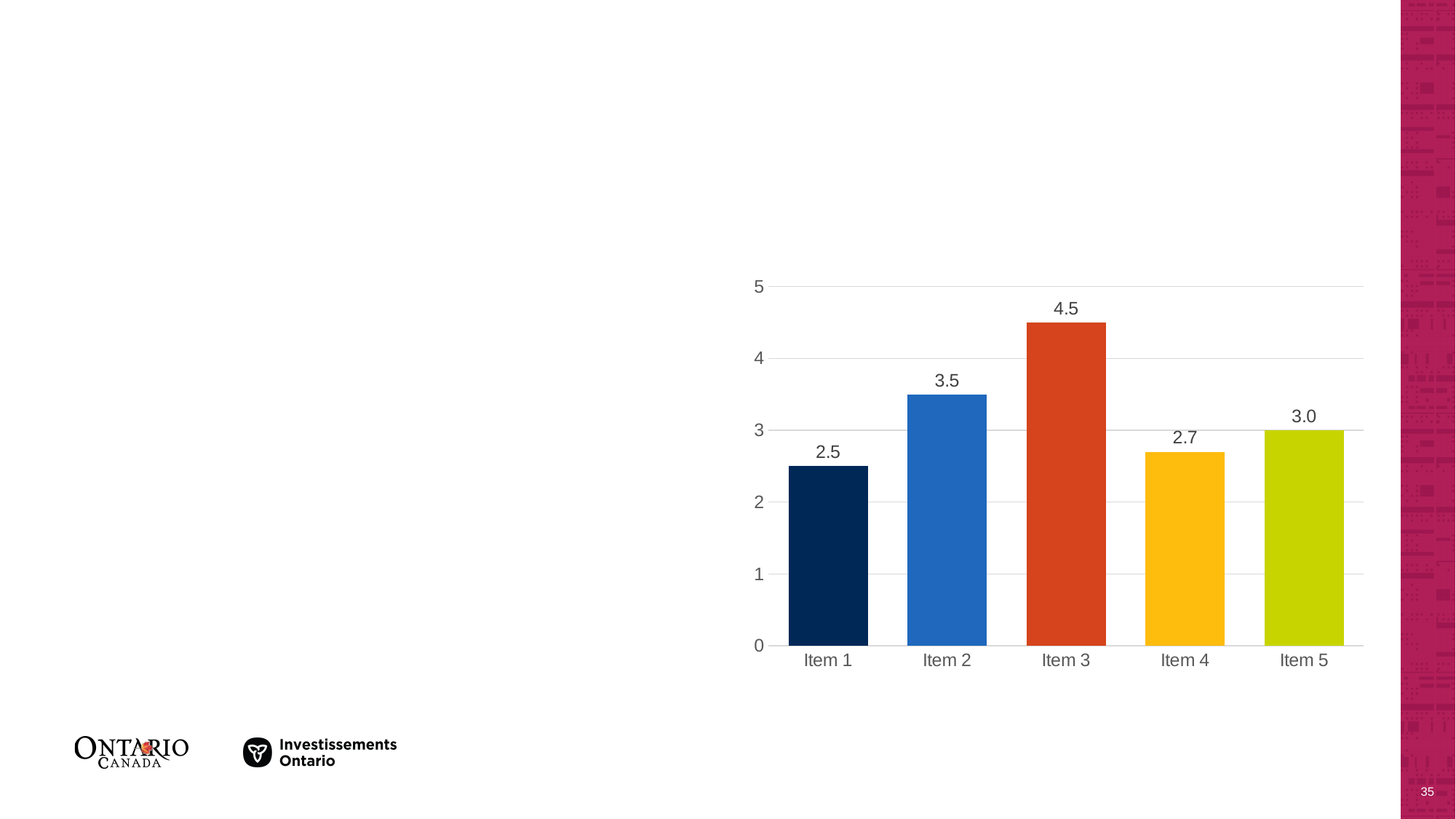
What is the value for Item 3? 4.5 What is the difference between the values for Item 3 and Item 2? 1.0 What colour is the bar for Item 3? orange-red What is the value for Item 1? 2.5 Which is larger, the value for Item 2 or the value for Item 4? Item 2 Which item has the highest value? Item 3 Is the value for Item 4 greater or less than 3? less Which item has the lowest value? Item 1 What is the difference between the values for Item 5 and Item 4? 0.3 What kind of chart is shown on the slide? bar chart What is the value for Item 5? 3.0 How many items are shown on the x axis? 5